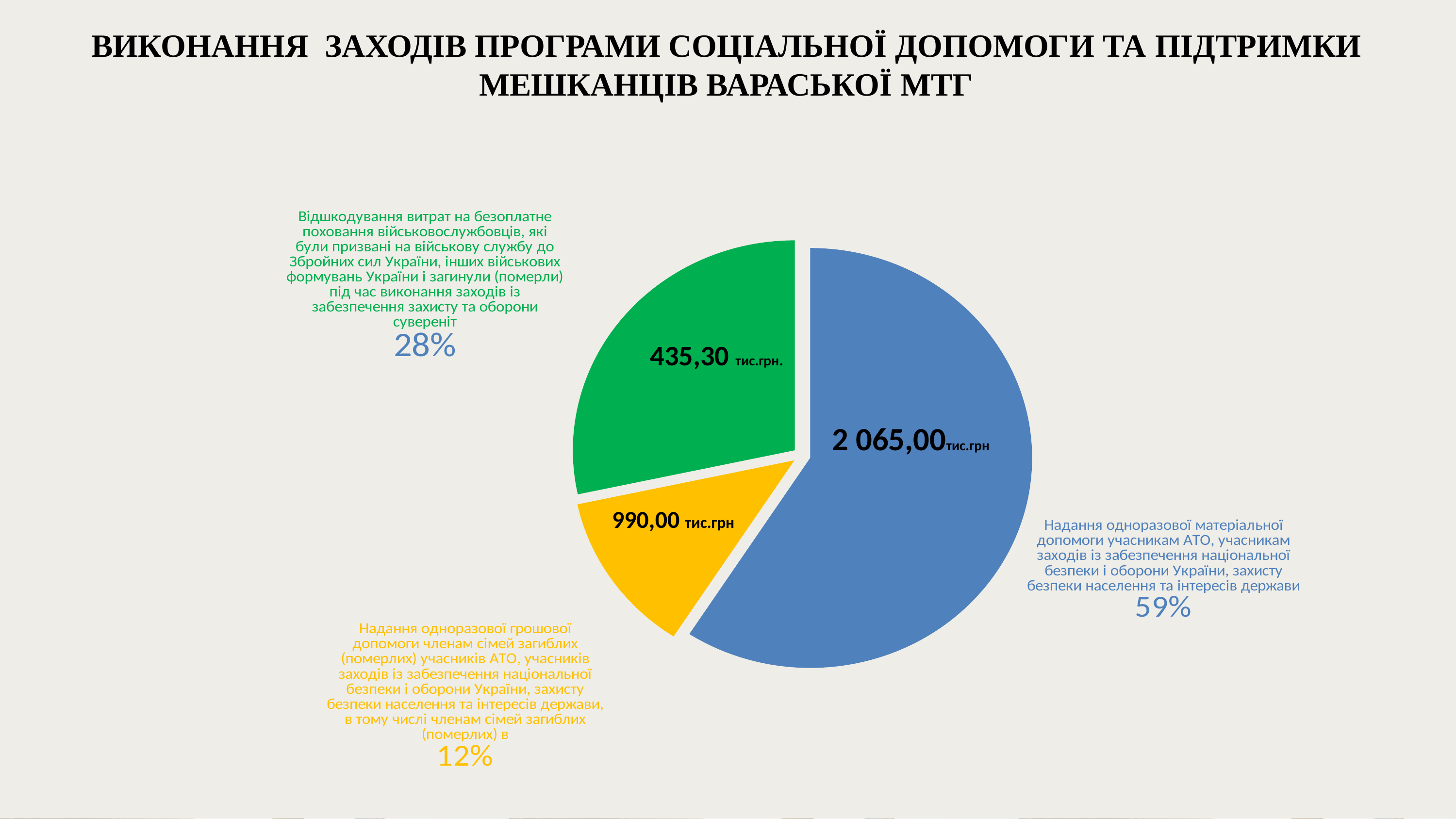
What type of chart is shown on the slide? pie chart Which slice of the pie chart has the largest value? 2 065,00 тис.грн (blue slice, Надання одноразової матеріальної допомоги учасникам АТО) What percentage share is shown for the blue slice (Надання одноразової матеріальної допомоги учасникам АТО)? 59% What colour is the slice labelled 2 065,00 тис.грн? blue What value is printed on the green slice of the pie chart? 435,30 тис.грн. What percentage share is shown for the yellow slice (Надання одноразової грошової допомоги членам сімей загиблих)? 12% What is the difference between the value on the blue slice and the value on the yellow slice? 1 075,00 тис.грн What value is printed on the blue slice of the pie chart? 2 065,00 тис.грн What value is printed on the yellow slice of the pie chart? 990,00 тис.грн How many slices does the pie chart have? 3 What percentage share is shown for the green slice (Відшкодування витрат на безоплатне поховання військовослужбовців)? 28% Is the value on the blue slice greater or less than the value on the yellow slice? greater